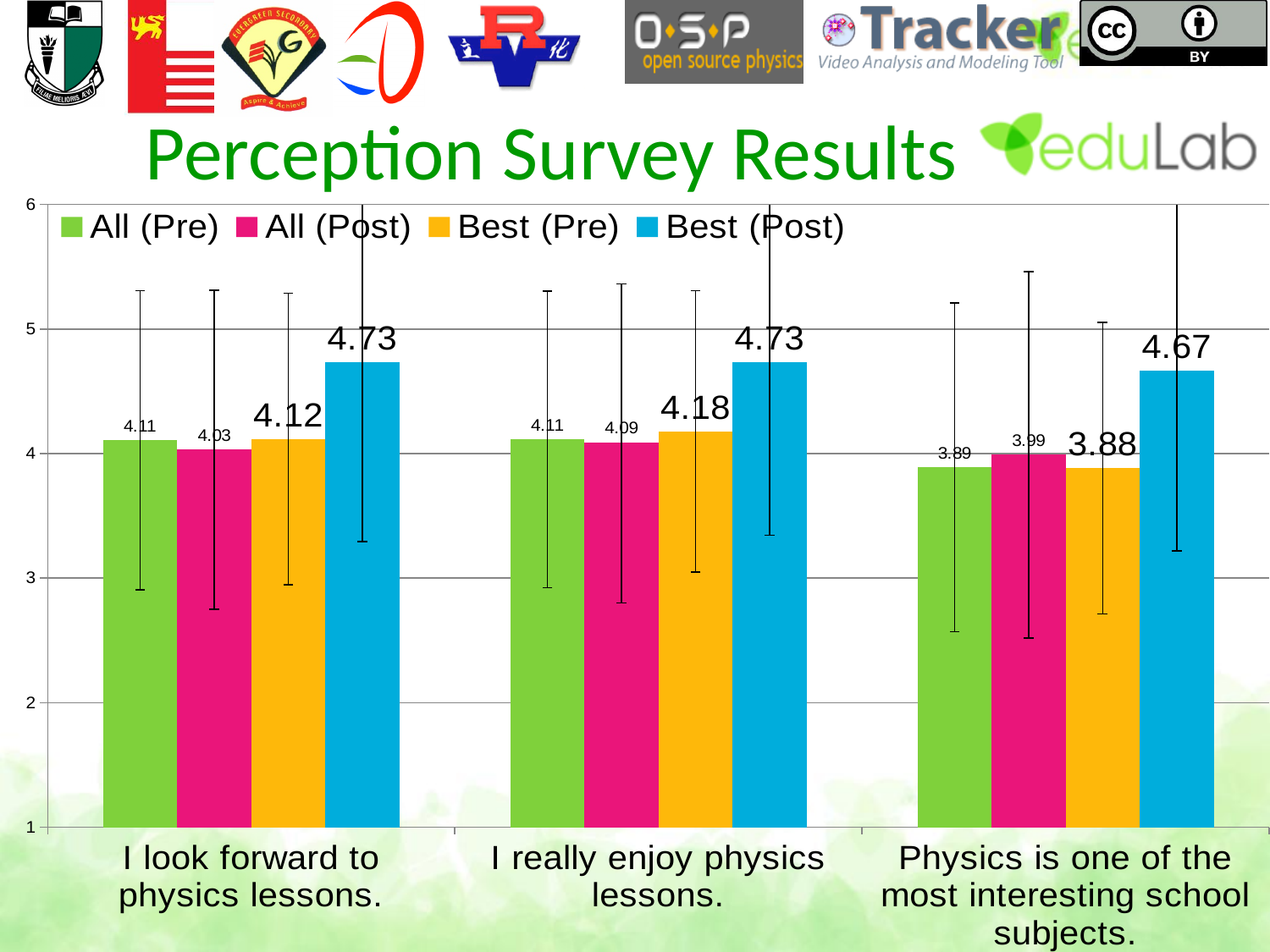
What is the Best (Post) value for "I look forward to physics lessons."? 4.73 What is the All (Post) value for "I look forward to physics lessons."? 4.03 How many categories (survey statements) are shown on the x axis? 3 How many series does the legend list? 4 What is the difference between the Best (Post) and Best (Pre) values for "I really enjoy physics lessons."? 0.55 What is the All (Pre) value for "Physics is one of the most interesting school subjects."? 3.89 Which series has the highest value for "Physics is one of the most interesting school subjects."? Best (Post) What is the title of the chart on the slide? Perception Survey Results What is the Best (Pre) value for "I really enjoy physics lessons."? 4.18 What kind of chart is shown on the slide? bar chart Which series has the lowest value for "Physics is one of the most interesting school subjects."? Best (Pre) Which is larger for "I look forward to physics lessons.": the All (Pre) value or the Best (Post) value? Best (Post)